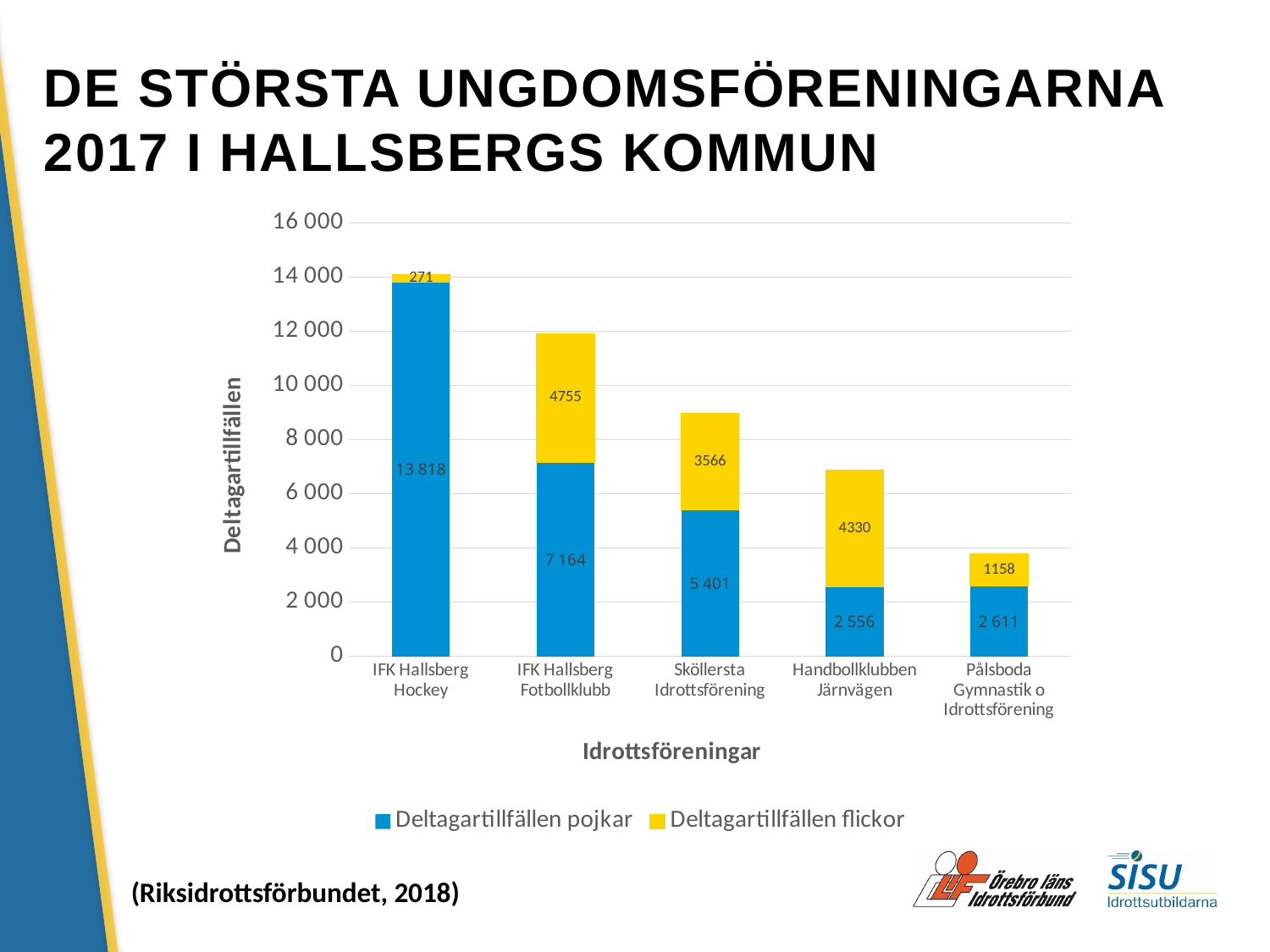
Which association has the lowest value for Deltagartillfällen flickor? IFK Hallsberg Hockey What is the value of Deltagartillfällen flickor for Handbollklubben Järnvägen? 4330 For Handbollklubben Järnvägen, which is larger: Deltagartillfällen pojkar or Deltagartillfällen flickor? Deltagartillfällen flickor Is the total stacked bar for IFK Hallsberg Fotbollklubb greater or less than 10 000? greater How many associations are shown on the x axis? 5 What is the difference between Deltagartillfällen pojkar and Deltagartillfällen flickor for Sköllersta Idrottsförening? 1835 What is the total of the stacked bar for Pålsboda Gymnastik o Idrottsförening? 3769 How many series does the legend list? 2 What kind of chart is shown on the slide? Stacked bar chart What is the value of Deltagartillfällen flickor for IFK Hallsberg Fotbollklubb? 4755 What is the value of Deltagartillfällen pojkar for IFK Hallsberg Hockey? 13 818 Which association has the highest value for Deltagartillfällen pojkar? IFK Hallsberg Hockey